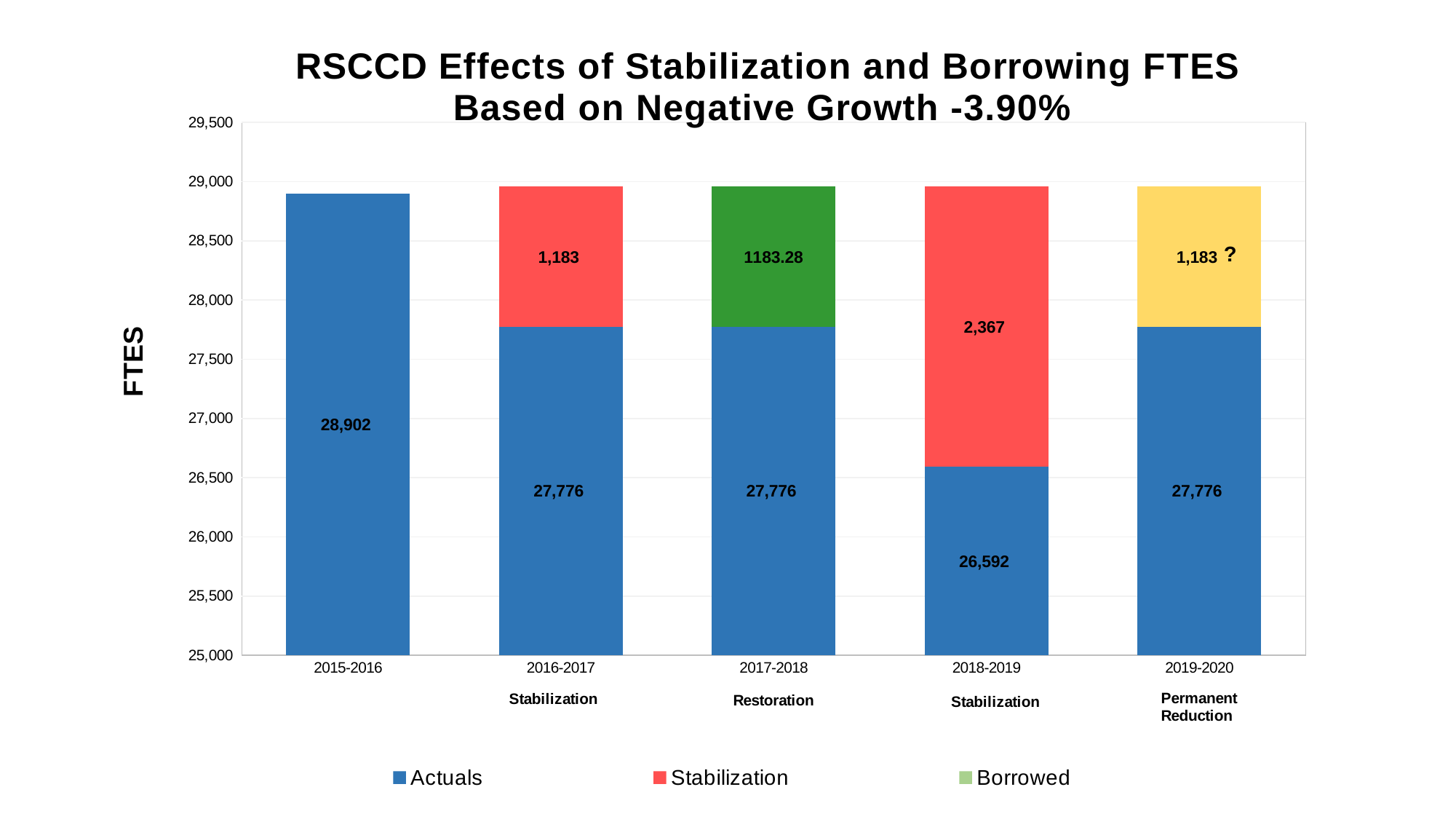
What is the Actuals value for 2015-2016? 28,902 What is the total of the stacked bar for 2016-2017 (Actuals plus Stabilization)? 28,959 Which year has the highest Actuals value? 2015-2016 What is the value of the green Borrowed segment for 2017-2018? 1183.28 What is the difference between the Actuals for 2015-2016 and the Actuals for 2016-2017? 1,126 How many series does the legend list? 3 What is the Actuals value for 2018-2019? 26,592 What kind of chart is shown on the slide? Stacked bar chart Which year has the lowest Actuals value? 2018-2019 How many year categories are shown on the x axis? 5 What is the Stabilization value for 2018-2019? 2,367 Which is larger, the Stabilization value for 2018-2019 or the Stabilization value for 2016-2017? 2018-2019